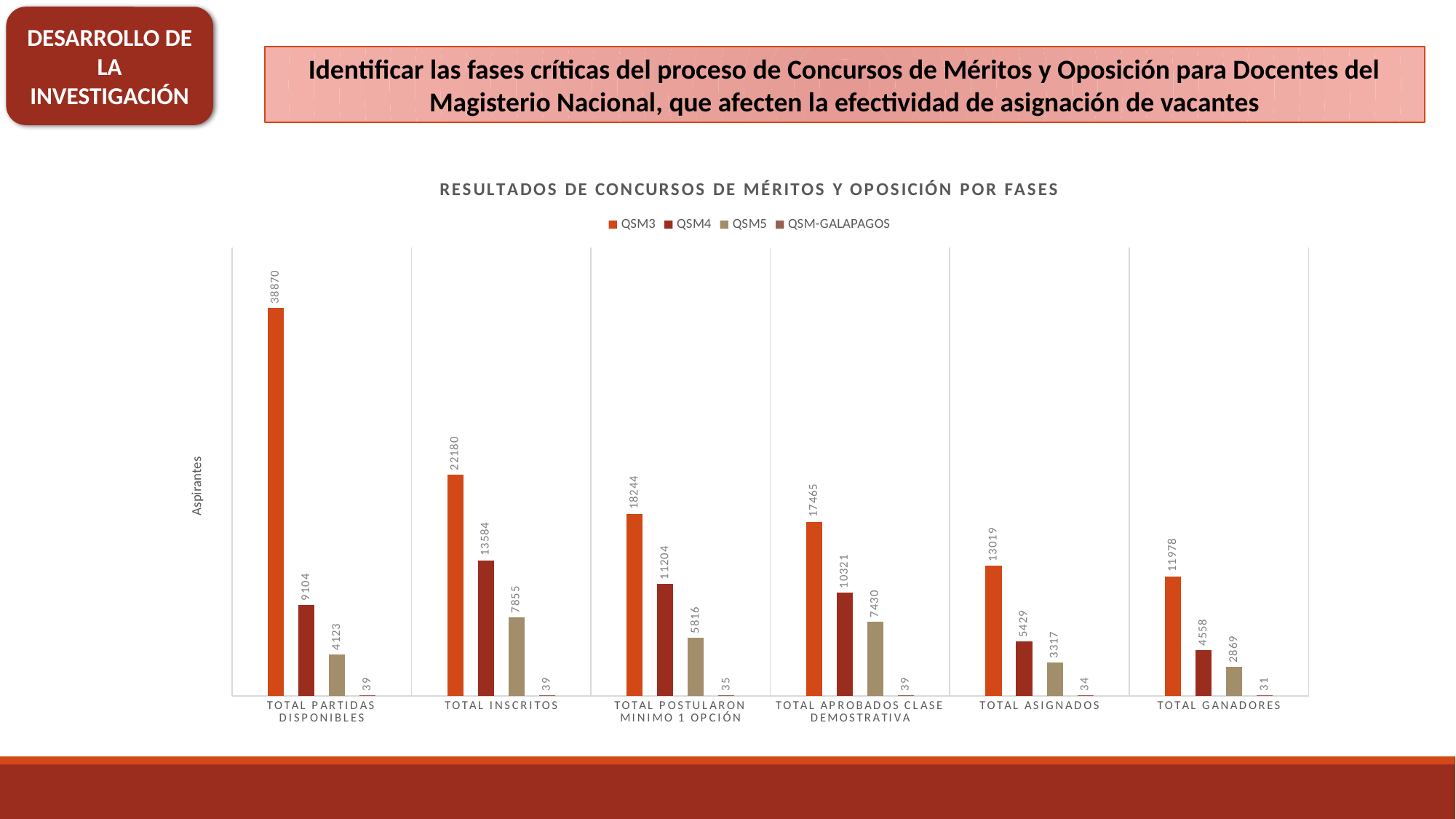
What is the value for QSM3 in the TOTAL PARTIDAS DISPONIBLES category? 38870 What is the difference between the QSM3 and QSM4 values in the TOTAL ASIGNADOS category? 7590 What is the value for QSM4 in the TOTAL INSCRITOS category? 13584 What is the value for QSM-GALAPAGOS in the TOTAL GANADORES category? 31 How many series does the legend list? 4 Which is larger: the QSM4 value for TOTAL POSTULARON MINIMO 1 OPCIÓN or the QSM4 value for TOTAL APROBADOS CLASE DEMOSTRATIVA? TOTAL POSTULARON MINIMO 1 OPCIÓN What is the value for QSM5 in the TOTAL APROBADOS CLASE DEMOSTRATIVA category? 7430 Which category has the highest value for QSM3? TOTAL PARTIDAS DISPONIBLES What is the label of the vertical axis of the chart? Aspirantes What kind of chart is shown on the slide? Bar chart Which category has the lowest value for QSM5? TOTAL GANADORES How many categories are shown on the x axis of the chart? 6